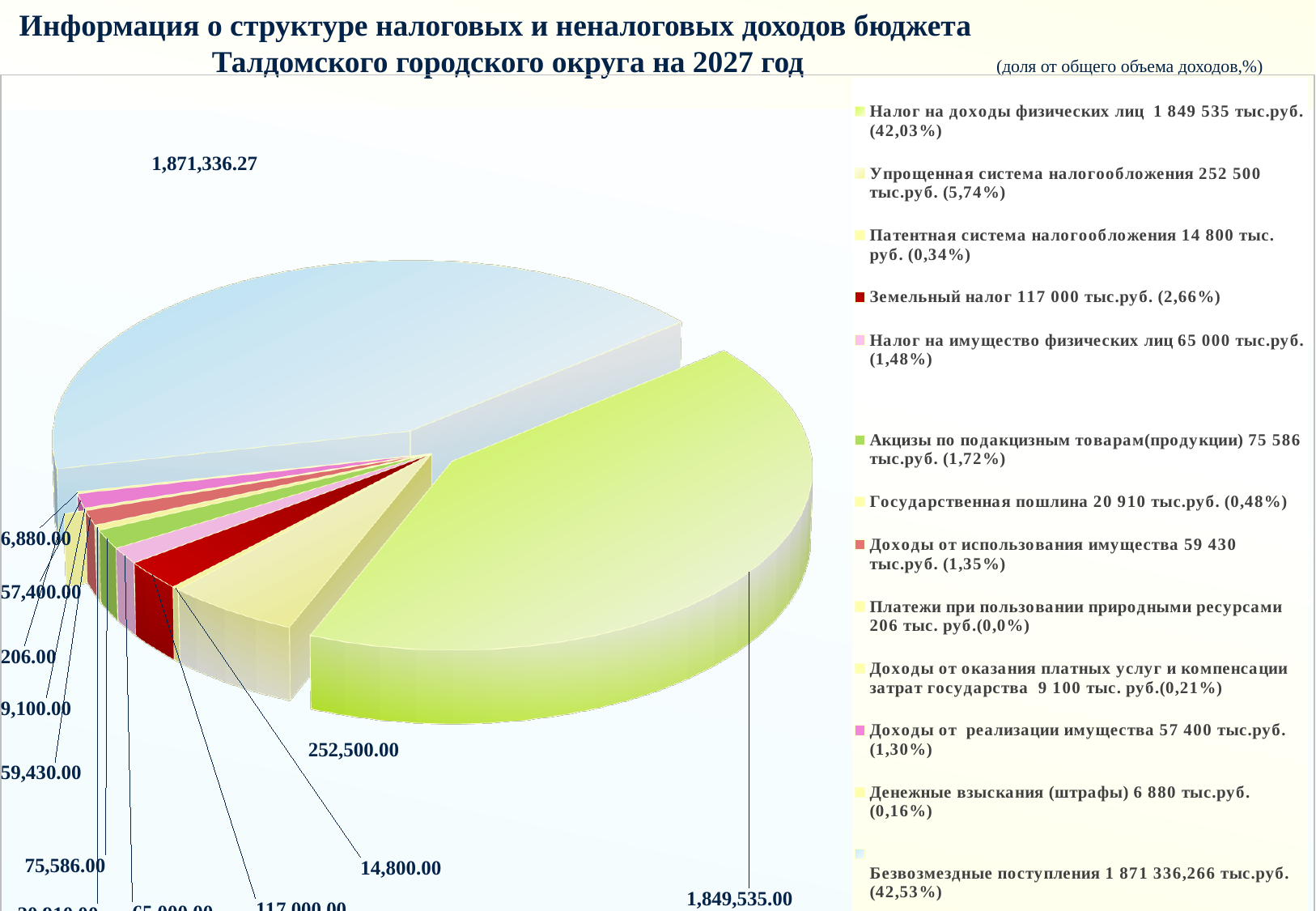
What share of total revenue does Доходы от реализации имущества represent, according to the legend? 1,30% What is the difference between the data label values for Упрощенная система налогообложения and Земельный налог? 135,500.00 What kind of chart is shown on the slide? pie chart Which is larger: the value for Налог на имущество физических лиц or the value for Доходы от использования имущества? Налог на имущество физических лиц Which category has the smallest slice of the pie? Платежи при пользовании природными ресурсами What is the data label value for the Упрощенная система налогообложения slice? 252,500.00 Which category has the largest slice of the pie? Безвозмездные поступления What share of total revenue does Налог на доходы физических лиц represent, according to the legend? 42,03% What is the data label value for the Акцизы по подакцизным товарам(продукции) slice? 75,586.00 What is the data label value for the Земельный налог slice? 117,000.00 What is the subtitle note shown in parentheses next to the chart title? (доля от общего объема доходов,%) How many categories (slices) does the pie chart have? 13